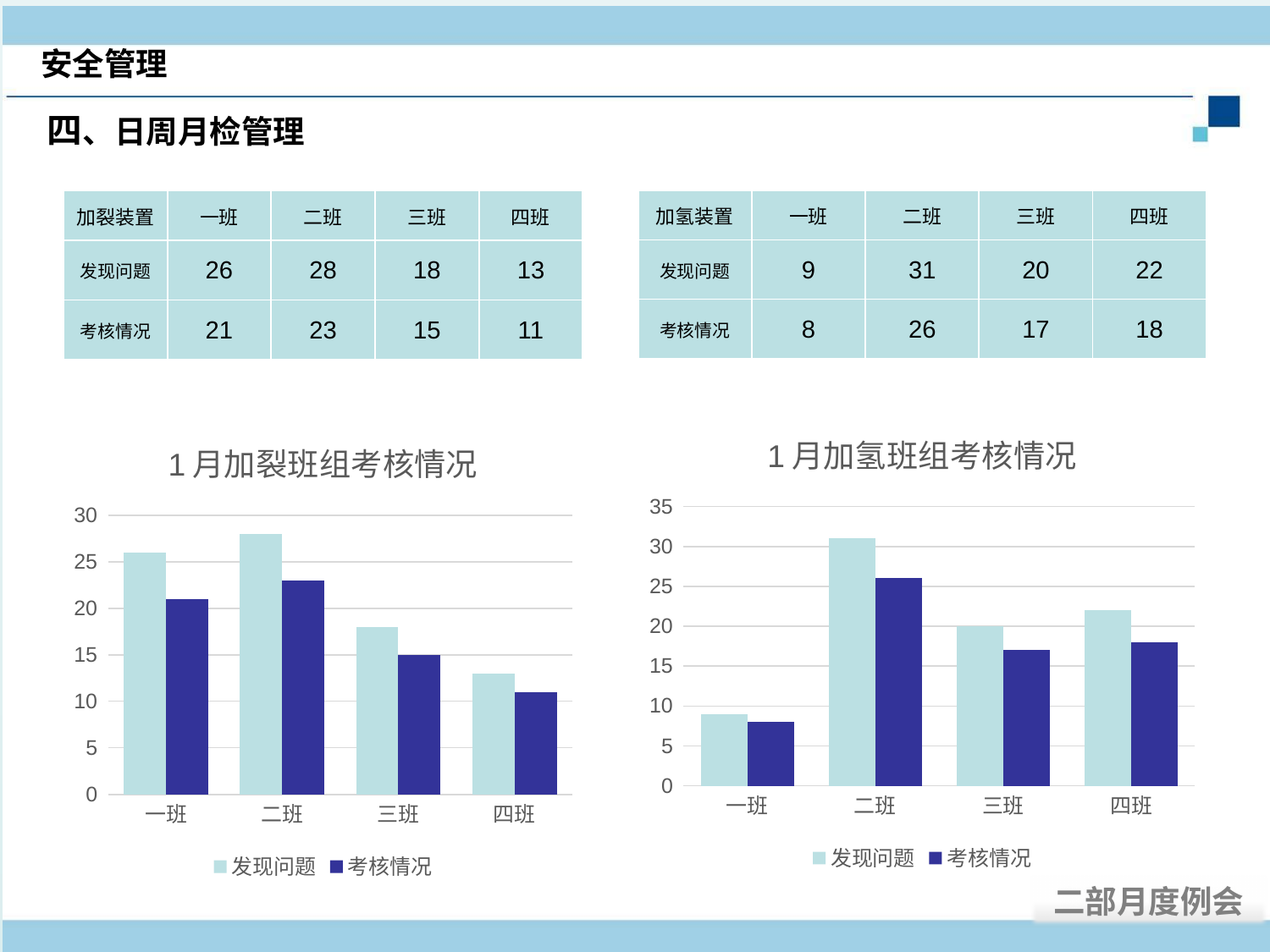
In the chart titled 1月加氢班组考核情况, is the 发现问题 value for 一班 greater or less than 10? less In the chart titled 1月加氢班组考核情况, which category has the highest 发现问题 value? 二班 What kind of chart is the chart titled 1月加裂班组考核情况? bar chart How many series does the legend of the chart titled 1月加氢班组考核情况 list? 2 In the chart titled 1月加裂班组考核情况, what is the value of 发现问题 for 二班? 28 In the chart titled 1月加氢班组考核情况, what is the difference between 发现问题 and 考核情况 for 二班? 5 How many categories are shown on the x axis of the chart titled 1月加裂班组考核情况? 4 In the chart titled 1月加裂班组考核情况, do the 发现问题 values rise or fall from 二班 to 四班? fall In the chart titled 1月加裂班组考核情况, which is larger: 考核情况 for 一班 or 考核情况 for 三班? 一班 In the chart titled 1月加裂班组考核情况, what is the difference between the 发现问题 values for 一班 and 四班? 13 In the chart titled 1月加氢班组考核情况, what is the value of 考核情况 for 三班? 17 In the chart titled 1月加裂班组考核情况, which category has the lowest 考核情况 value? 四班